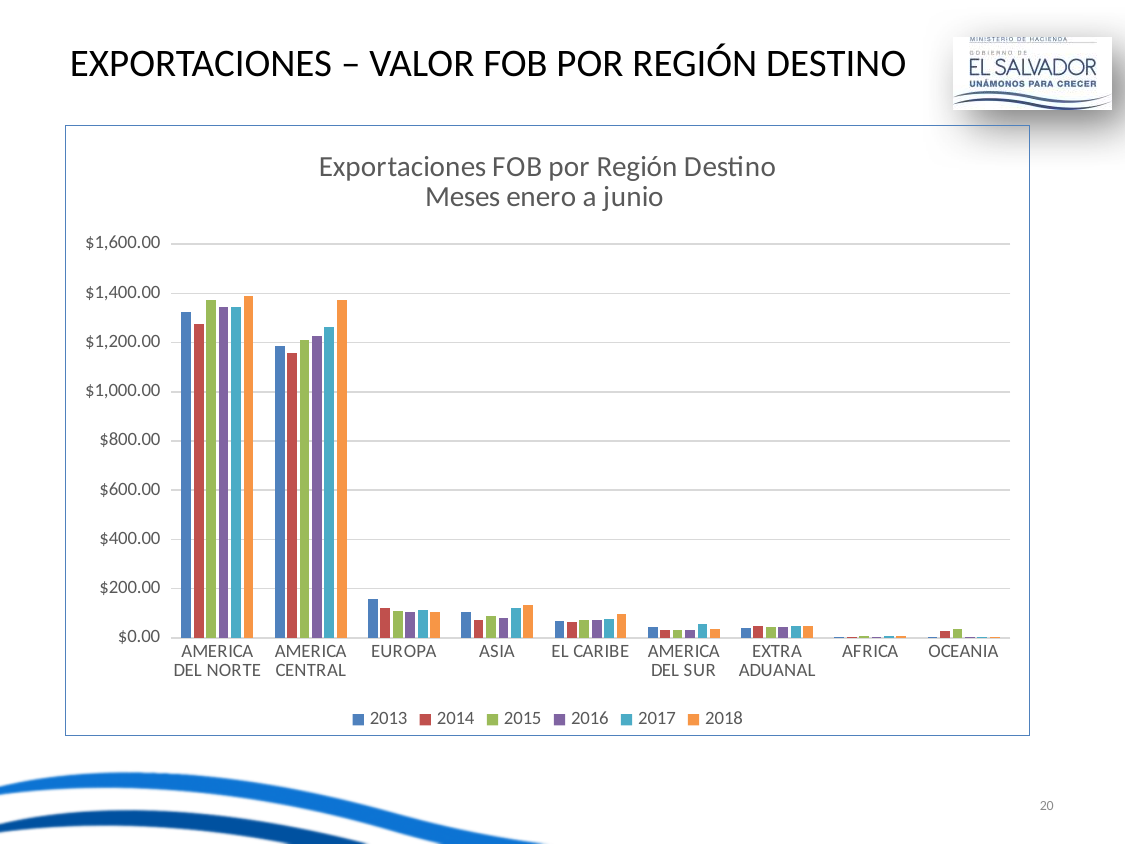
Do the values for AMERICA CENTRAL rise or fall from 2014 to 2018? rise Is the 2013 value for EUROPA greater or less than $200.00? less Is the 2013 value for AMERICA DEL NORTE greater or less than $1,200.00? greater Within AMERICA DEL NORTE, which year has the lowest bar? 2014 What is the title of the chart? Exportaciones FOB por Región Destino Meses enero a junio What kind of chart is shown on the slide? bar chart Which is larger, the 2013 value for EUROPA or the 2013 value for ASIA? EUROPA Within AMERICA CENTRAL, which year has the highest bar? 2018 Within AMERICA CENTRAL, which year has the lowest bar? 2014 How many destination regions are shown on the x axis of the chart? 9 Which region has the highest export values in the chart? AMERICA DEL NORTE How many series does the legend of the chart list? 6